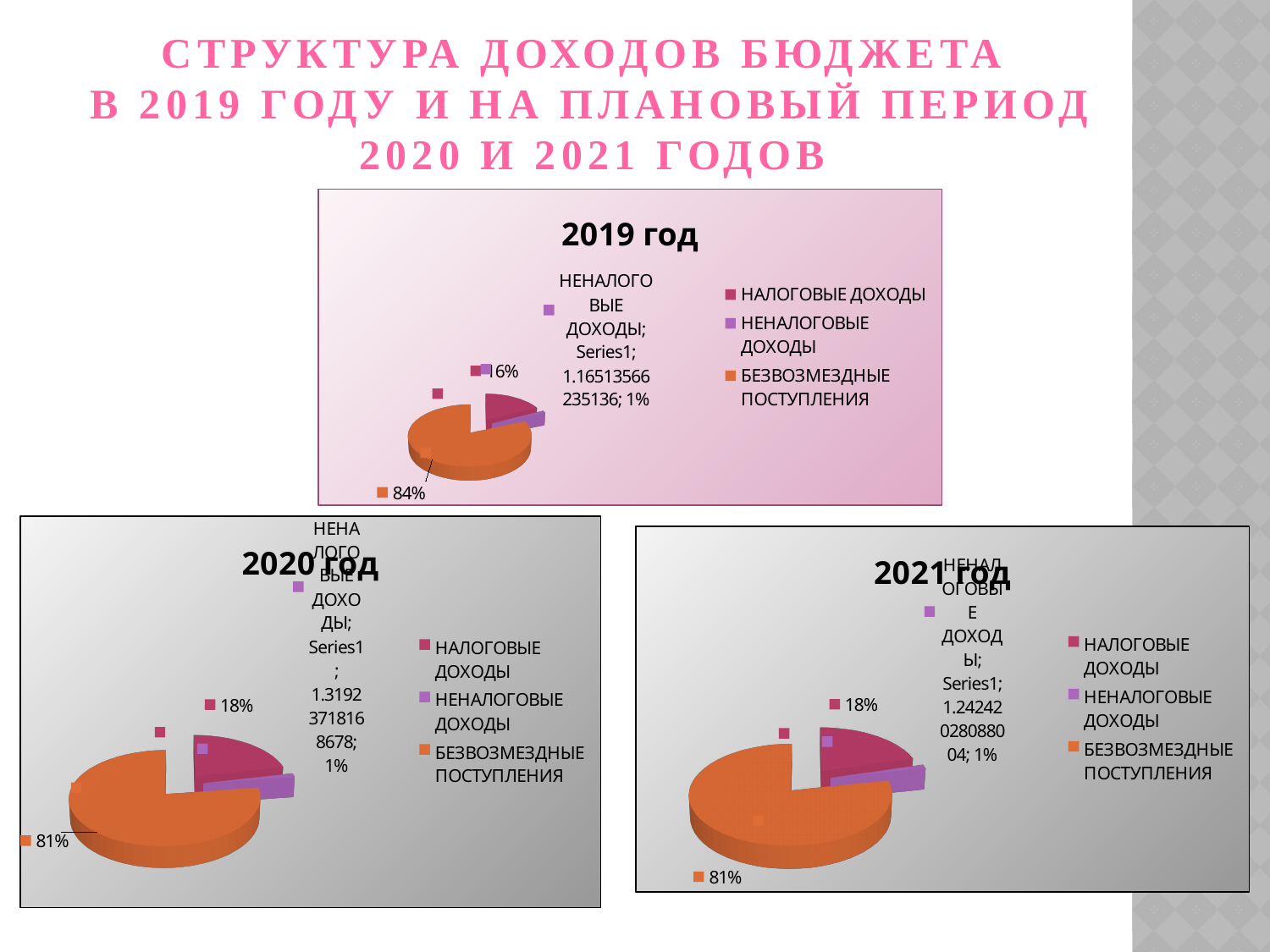
In the "2021 год" chart, what share of the pie is НАЛОГОВЫЕ ДОХОДЫ? 18% In the "2020 год" chart, which category has the smallest slice? НЕНАЛОГОВЫЕ ДОХОДЫ In the "2019 год" chart, what is the difference in percentage points between БЕЗВОЗМЕЗДНЫЕ ПОСТУПЛЕНИЯ and НАЛОГОВЫЕ ДОХОДЫ? 68 percentage points In the "2021 год" chart, which category has the largest slice? БЕЗВОЗМЕЗДНЫЕ ПОСТУПЛЕНИЯ In the "2019 год" chart, what share of the pie is НЕНАЛОГОВЫЕ ДОХОДЫ? 1% In the "2019 год" chart, what share of the pie is НАЛОГОВЫЕ ДОХОДЫ? 16% What kind of chart is the "2020 год" chart? Pie chart How many categories does the legend of the "2021 год" chart list? 3